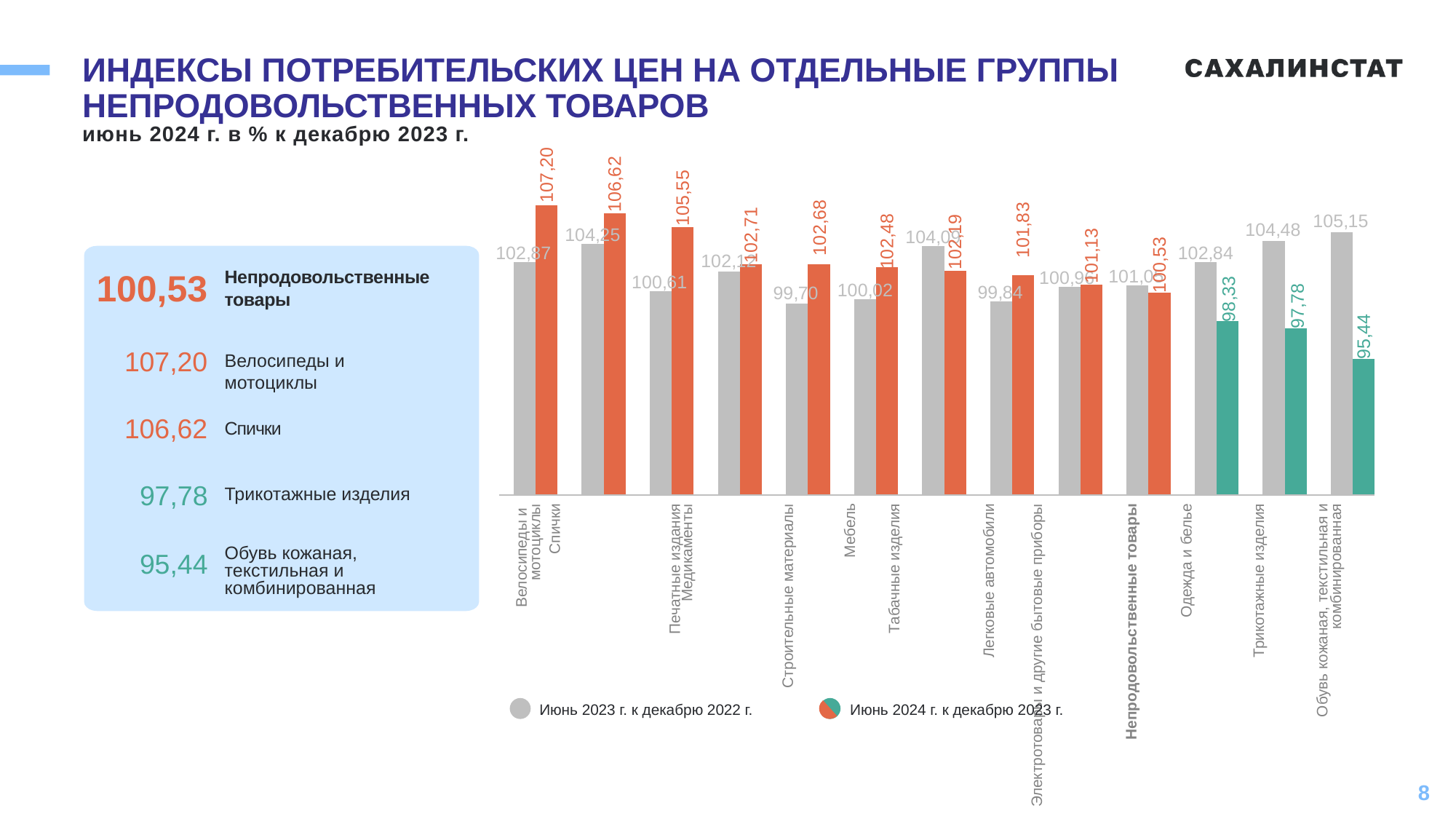
What is the value for Одежда и белье in the series 'Июнь 2024 г. к декабрю 2023 г.'? 98,33 What kind of chart is shown on the slide? bar chart What is the difference between the 'Июнь 2024 г. к декабрю 2023 г.' values for Велосипеды и мотоциклы and Спички? 0,58 How many series does the legend list? 2 What is the value for Медикаменты in the series 'Июнь 2023 г. к декабрю 2022 г.'? 102,12 For Табачные изделия, which series has the larger value: 'Июнь 2023 г. к декабрю 2022 г.' or 'Июнь 2024 г. к декабрю 2023 г.'? Июнь 2023 г. к декабрю 2022 г. Which category has the lowest value in the series 'Июнь 2024 г. к декабрю 2023 г.'? Обувь кожаная, текстильная и комбинированная How many product categories are shown on the x axis of the chart? 13 Which category has the highest value in the series 'Июнь 2024 г. к декабрю 2023 г.'? Велосипеды и мотоциклы What is the value for Спички in the series 'Июнь 2024 г. к декабрю 2023 г.'? 106,62 What period does the chart's subtitle say the data refers to? июнь 2024 г. в % к декабрю 2023 г. What is the value for Строительные материалы in the series 'Июнь 2023 г. к декабрю 2022 г.'? 99,70